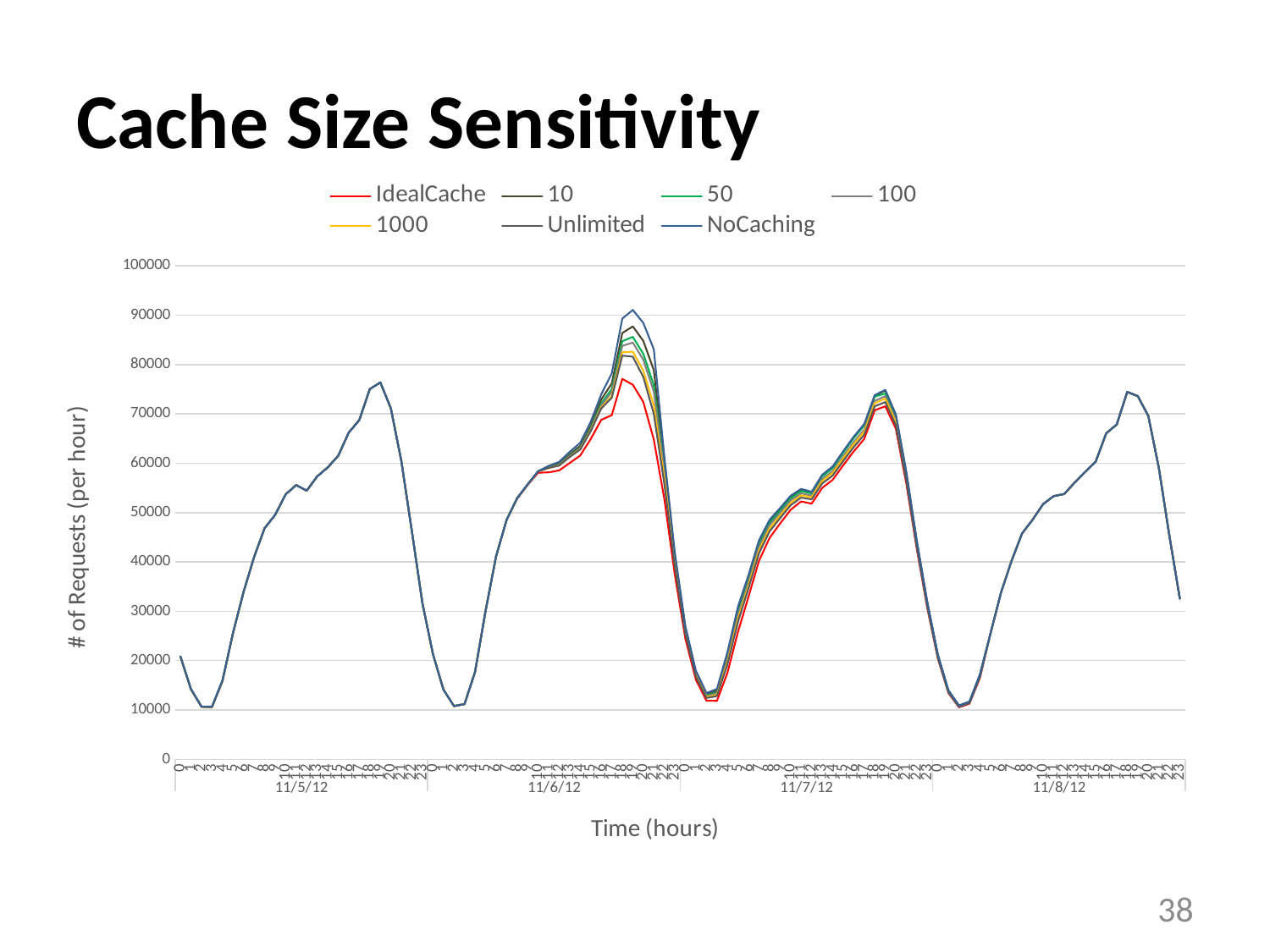
Which series reaches the highest value at the peak on 11/6/12? NoCaching At the peak on 11/6/12, which is larger: the NoCaching value or the IdealCache value? NoCaching What kind of chart is shown on the slide? line chart What is the title of the chart on the slide? Cache Size Sensitivity Is the peak value for NoCaching on 11/8/12 greater or less than 70000? greater Which series has the lowest value at the peak on 11/6/12? IdealCache Is the peak value for IdealCache on 11/6/12 greater or less than 80000? less What is the label of the vertical axis? # of Requests (per hour) How many series does the legend list? 7 How many dates are marked along the x axis? 4 Is the peak value for NoCaching on 11/5/12 greater or less than 70000? greater